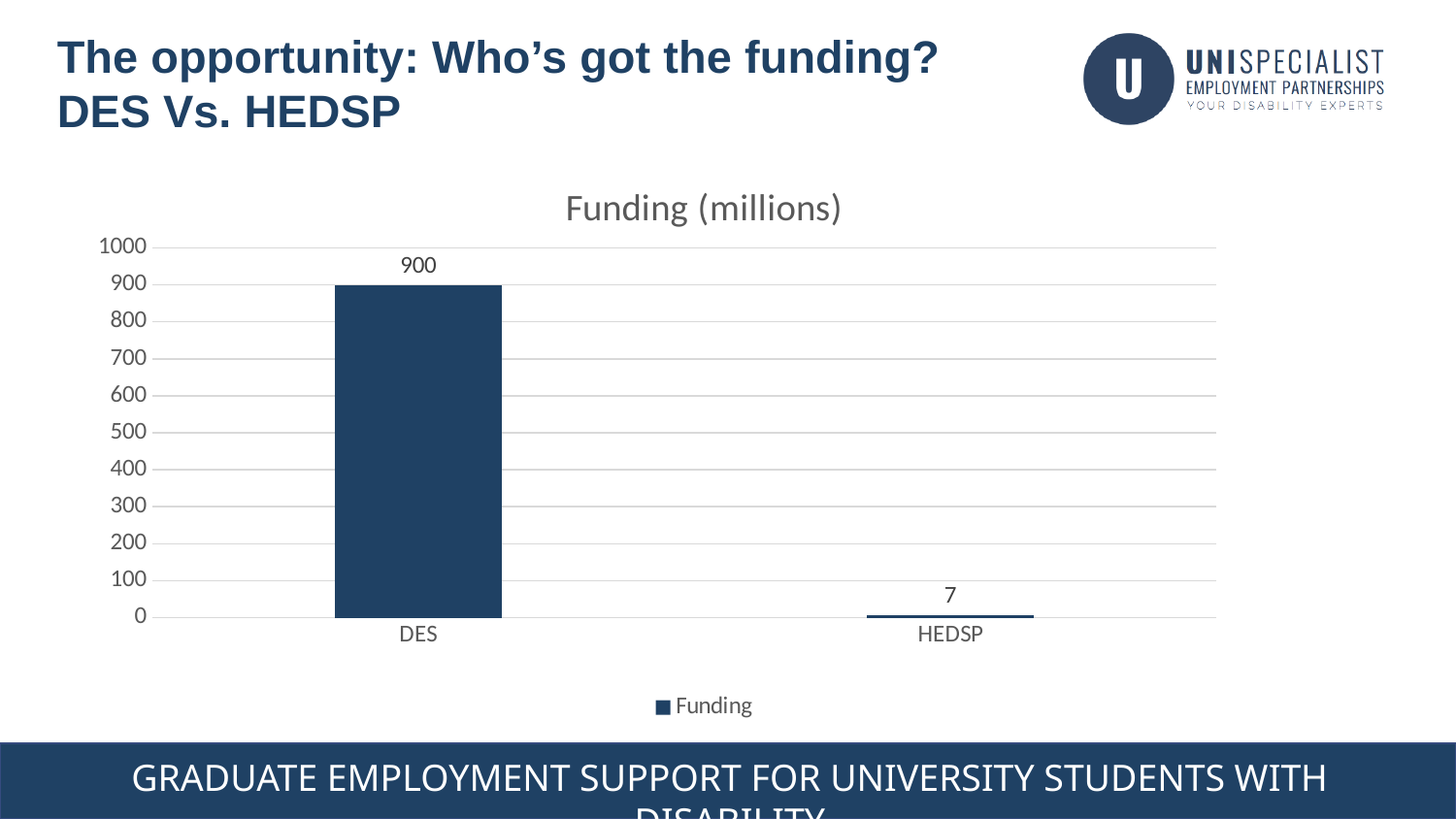
Which category has the highest funding? DES How many series does the legend list? 1 Is the value for HEDSP greater or less than 100? less Which has larger funding, DES or HEDSP? DES What kind of chart is shown on the slide? Bar chart What is the funding value for DES? 900 Is the value for DES greater or less than 500? greater Which category has the lowest funding? HEDSP What is the funding value for HEDSP? 7 What is the title of the chart? Funding (millions) How many categories are shown on the x axis? 2 What is the difference in funding between DES and HEDSP? 893